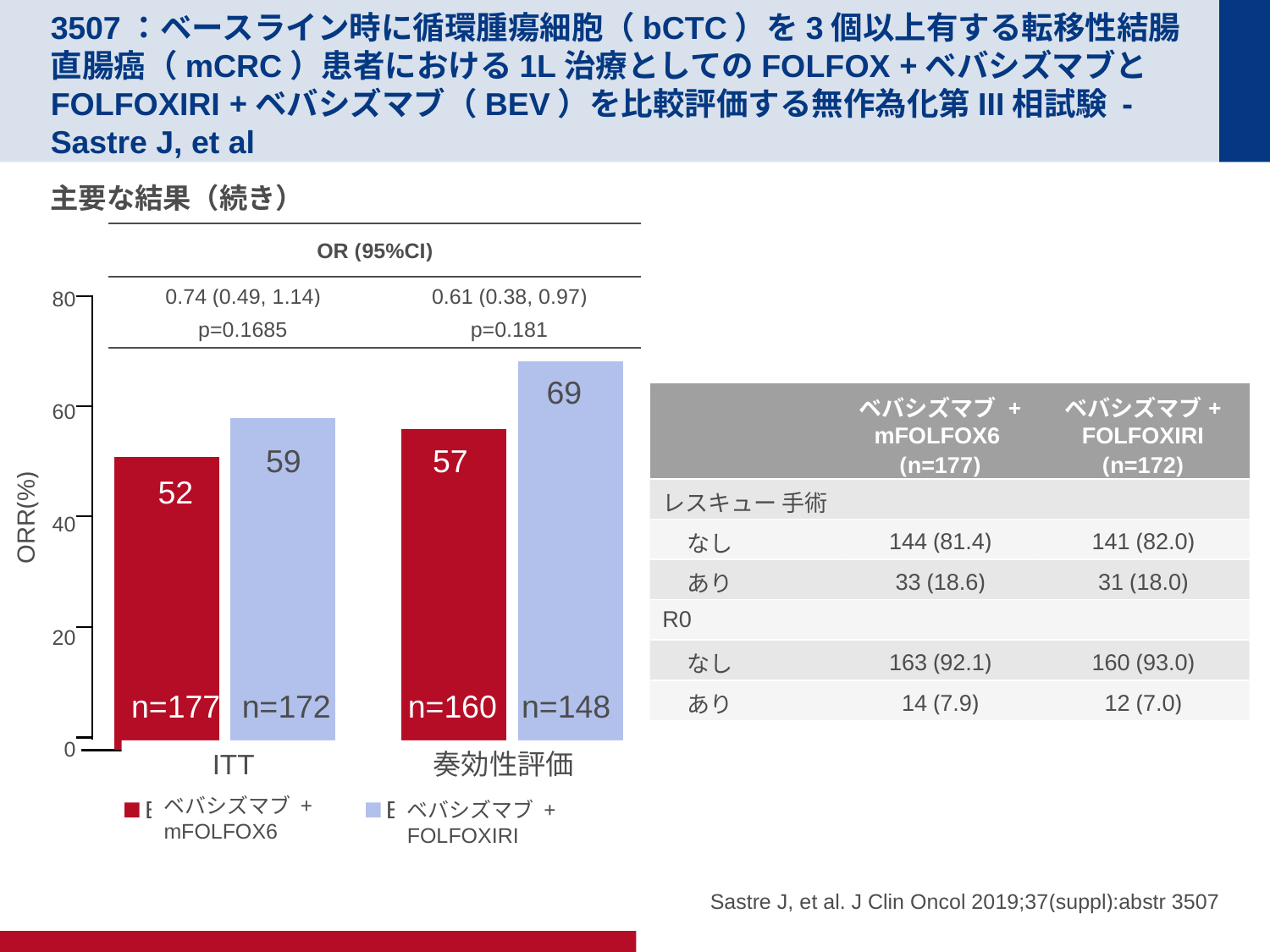
What is the ORR(%) for ベバシズマブ + mFOLFOX6 in the 奏効性評価 group? 57 What is the difference in ORR(%) between ベバシズマブ + FOLFOXIRI and ベバシズマブ + mFOLFOX6 in the 奏効性評価 group? 12 What is the ORR(%) for ベバシズマブ + FOLFOXIRI in the ITT group? 59 What is the label of the y axis of the chart? ORR(%) What is the ORR(%) for ベバシズマブ + mFOLFOX6 in the ITT group? 52 How many series does the chart legend list? 2 Which bar has the lowest ORR(%) in the chart? ベバシズマブ + mFOLFOX6 in ITT Which bar has the highest ORR(%) in the chart? ベバシズマブ + FOLFOXIRI in 奏効性評価 What is the ORR(%) for ベバシズマブ + FOLFOXIRI in the 奏効性評価 group? 69 What kind of chart is shown on the slide? Bar chart In the ITT group, which series has the higher ORR(%): ベバシズマブ + mFOLFOX6 or ベバシズマブ + FOLFOXIRI? ベバシズマブ + FOLFOXIRI What is the difference in ORR(%) between ベバシズマブ + FOLFOXIRI and ベバシズマブ + mFOLFOX6 in the ITT group? 7